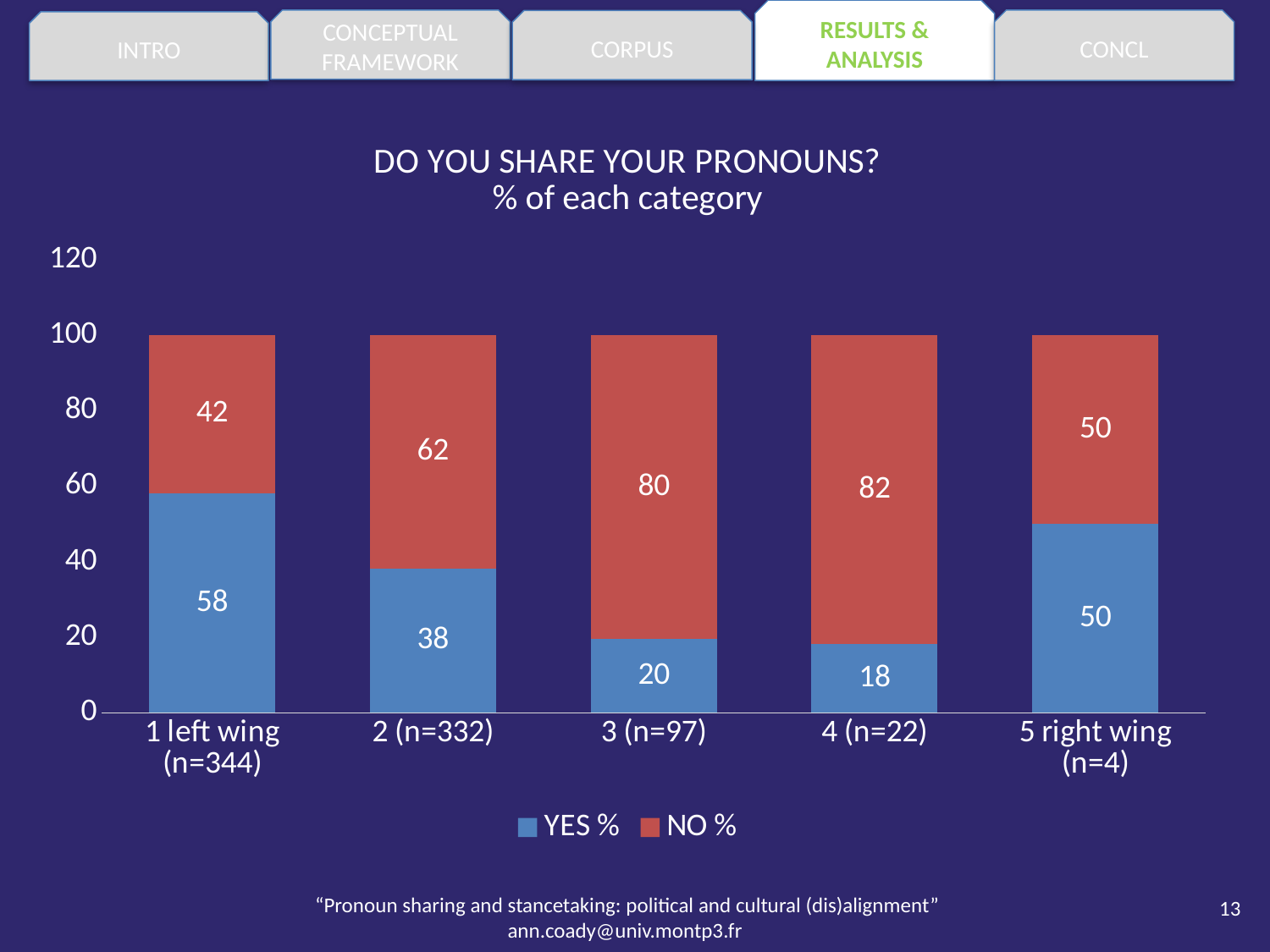
Which category has the highest YES % value? 1 left wing (n=344) What kind of chart is shown on the slide? Stacked bar chart What is the YES % value for the category 2 (n=332)? 38 What is the YES % value for 1 left wing (n=344)? 58 What is the NO % value for the category 4 (n=22)? 82 What is the difference between the NO % values for 3 (n=97) and 1 left wing (n=344)? 38 What is the total of the stacked bar for 3 (n=97)? 100 How many series does the legend list? 2 How many categories are shown on the x axis? 5 Which category has the lowest YES % value? 4 (n=22) Which is larger: the YES % for 2 (n=332) or the YES % for 5 right wing (n=4)? 5 right wing (n=4) What is the title of the chart? DO YOU SHARE YOUR PRONOUNS? % of each category